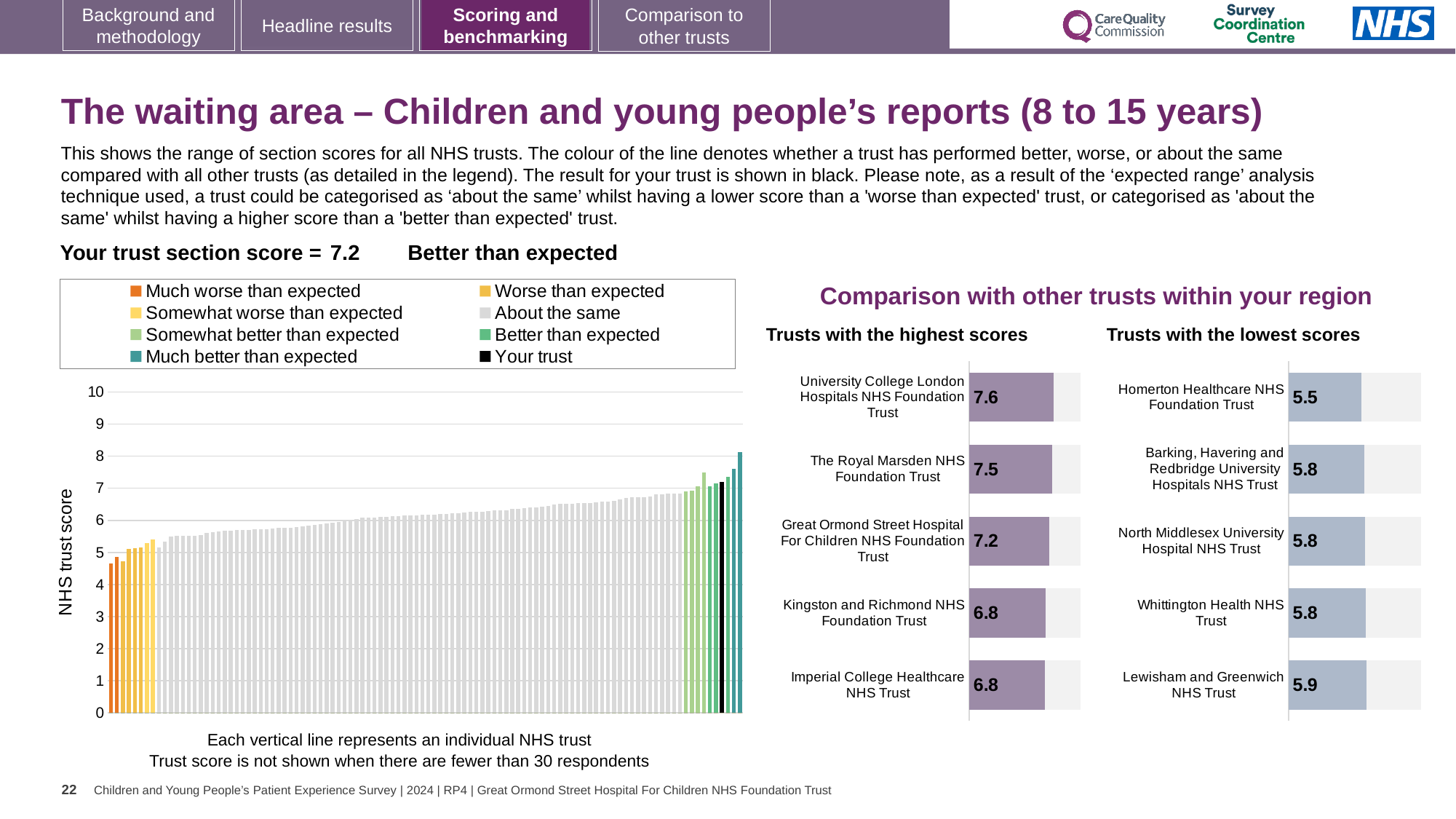
In the 'Trusts with the highest scores' chart, what is the score for University College London Hospitals NHS Foundation Trust? 7.6 In the 'Trusts with the highest scores' chart, what is the score for Great Ormond Street Hospital For Children NHS Foundation Trust? 7.2 What kind of chart is the main chart on the left showing NHS trust scores? Bar chart In the 'Trusts with the lowest scores' chart, which trust has the lowest score? Homerton Healthcare NHS Foundation Trust How many trusts are shown in the 'Trusts with the lowest scores' chart? 5 In the main chart on the left, do the trust scores rise or fall from left to right along the x axis? Rise In the 'Trusts with the highest scores' chart, which has the higher score: The Royal Marsden NHS Foundation Trust or Kingston and Richmond NHS Foundation Trust? The Royal Marsden NHS Foundation Trust In the 'Trusts with the lowest scores' chart, what is the score for Lewisham and Greenwich NHS Trust? 5.9 In the 'Trusts with the highest scores' chart, which trust has the highest score? University College London Hospitals NHS Foundation Trust In the 'Trusts with the highest scores' chart, what is the difference between the scores of University College London Hospitals NHS Foundation Trust and Great Ormond Street Hospital For Children NHS Foundation Trust? 0.4 In the main chart on the left, is the value of the lowest (leftmost) bar greater or less than 5? less In the main chart on the left, how many entries does the legend list? 8